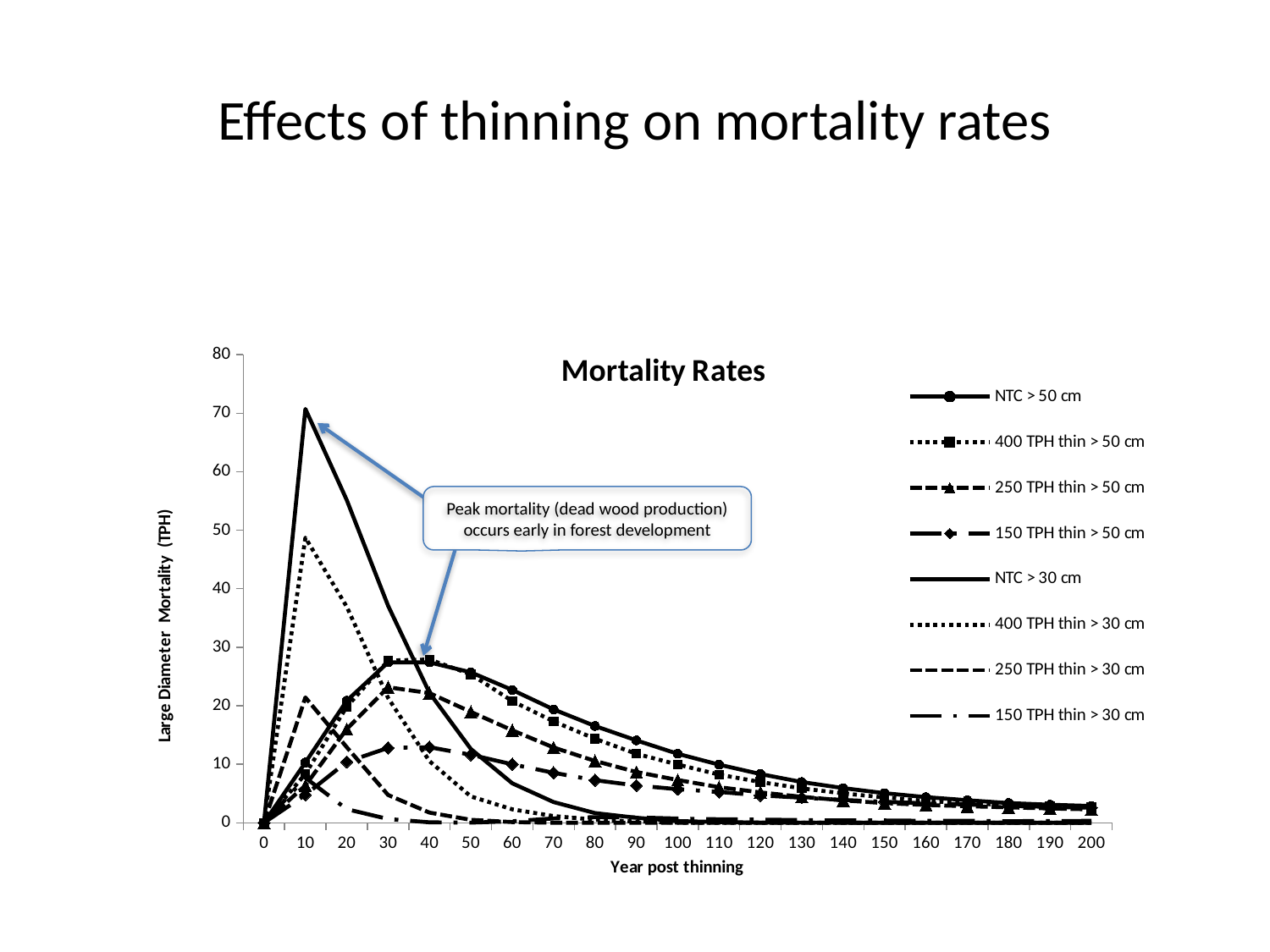
Do the values for NTC > 30 cm rise or fall from year 10 to year 200? fall Is the value for 150 TPH thin > 30 cm at year 10 greater or less than 10? less Is the value for NTC > 50 cm at year 40 greater or less than 20? greater What is the label of the x axis of the chart? Year post thinning Is the value for NTC > 30 cm at year 10 greater or less than 60? greater How many series does the legend of the Mortality Rates chart list? 8 What is the title of the chart? Mortality Rates What kind of chart is shown on the slide? line chart At year 10, which series has the larger value: NTC > 30 cm or 250 TPH thin > 30 cm? NTC > 30 cm Which series reaches the highest peak value on the chart? NTC > 30 cm